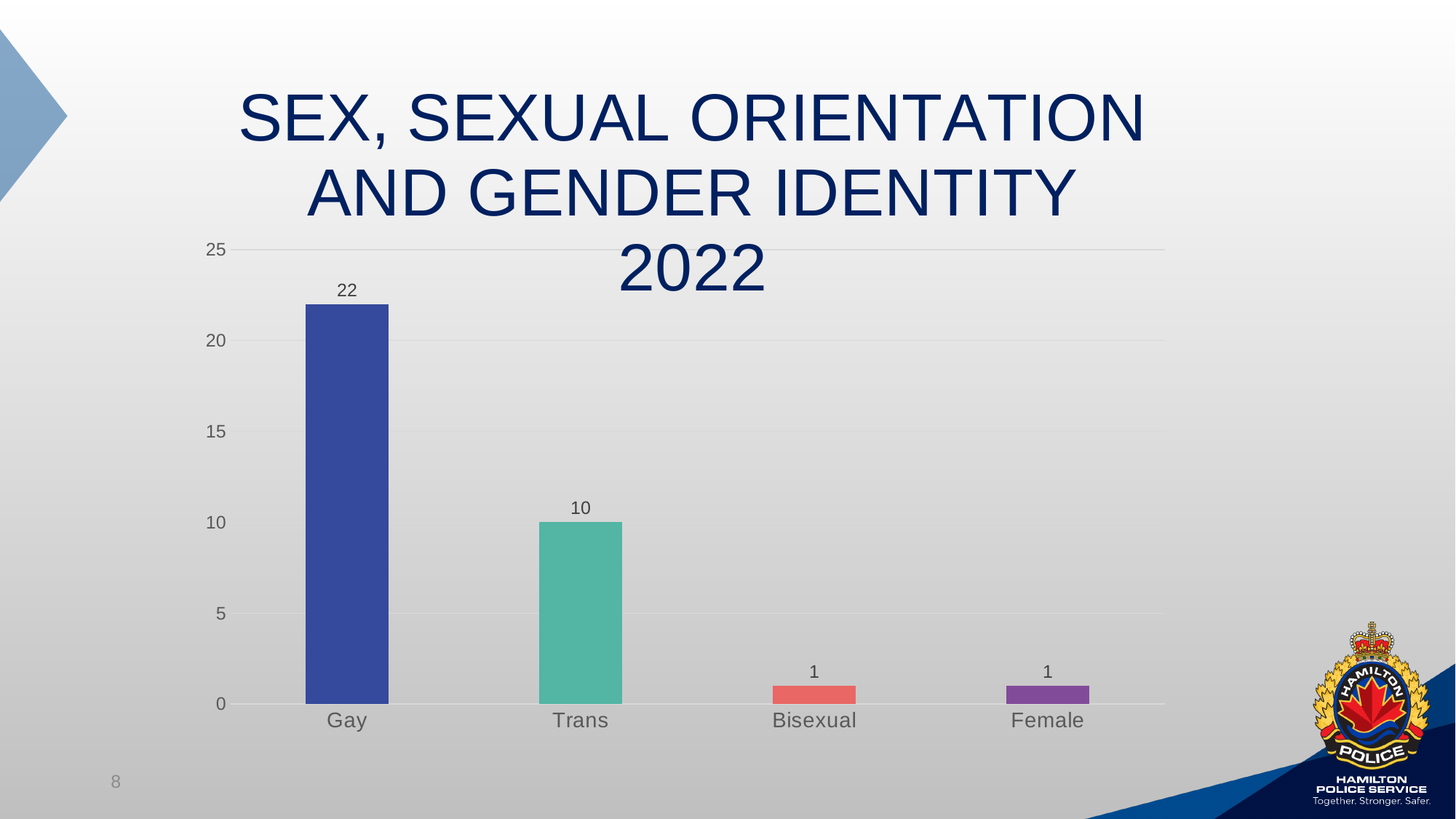
What is the difference between the values for Gay and Trans? 12 Which is larger, the value for Trans or the value for Bisexual? Trans What colour is the bar for Trans? teal What is the value for Trans? 10 Which category has the highest value? Gay What is the value for Female? 1 What kind of chart is shown on the slide? bar chart What is the title of the slide? SEX, SEXUAL ORIENTATION AND GENDER IDENTITY 2022 What is the value for Gay? 22 Is the value for Gay greater or less than 20? greater How many categories are shown on the x axis? 4 What is the value for Bisexual? 1